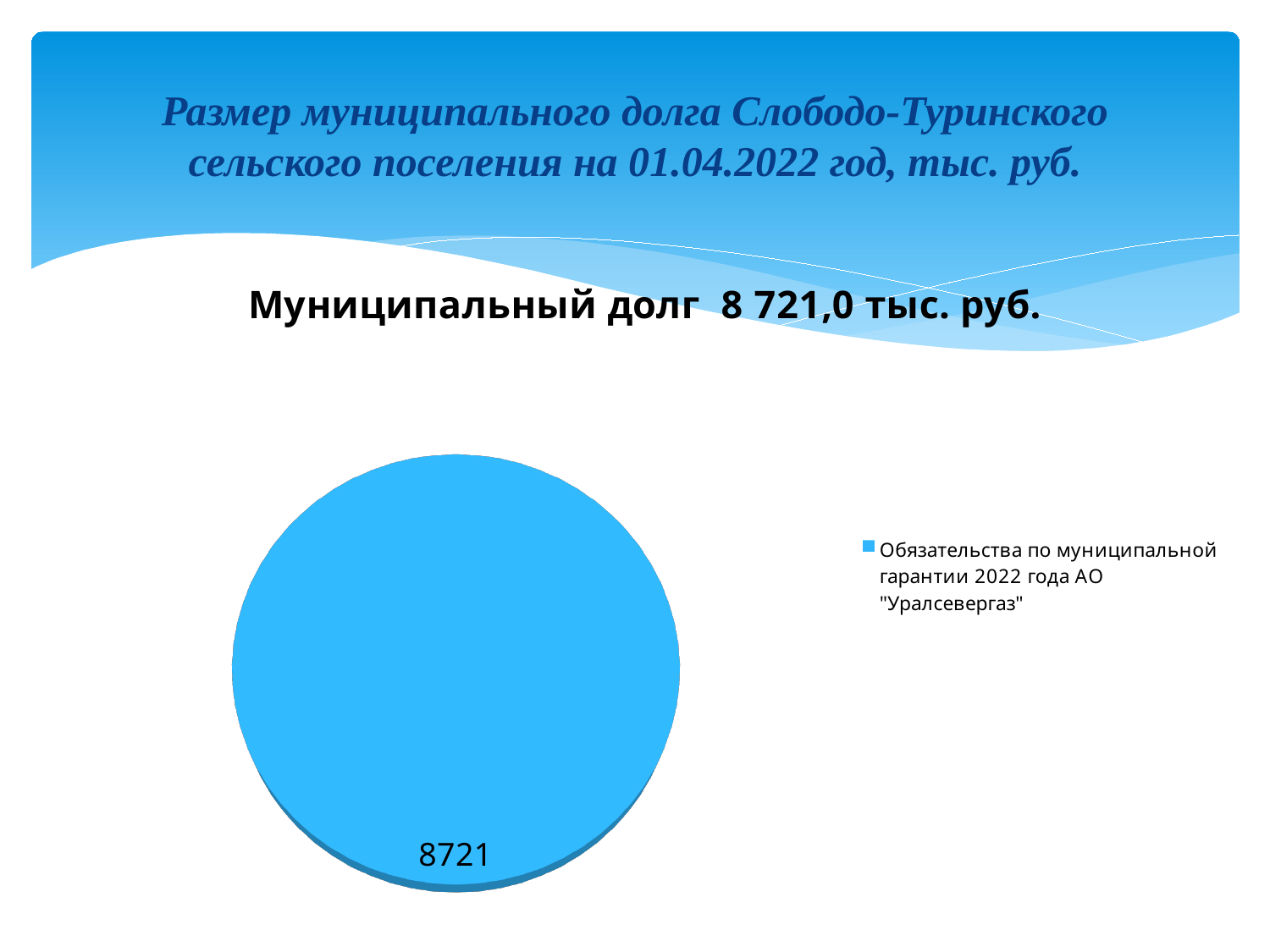
What is the value for Обязательства по муниципальной гарантии 2022 года АО "Уралсевергаз"? 8721 How many entries does the legend list? 1 What is the legend entry of the pie chart? Обязательства по муниципальной гарантии 2022 года АО "Уралсевергаз" Is the value shown on the pie slice greater or less than 8000? greater What colour is the pie slice? blue What kind of chart is shown on the slide? pie chart How many slices does the pie chart have? 1 What share of the pie does the slice for Обязательства по муниципальной гарантии 2022 года АО "Уралсевергаз" represent? 100% What value is printed on the pie slice? 8721